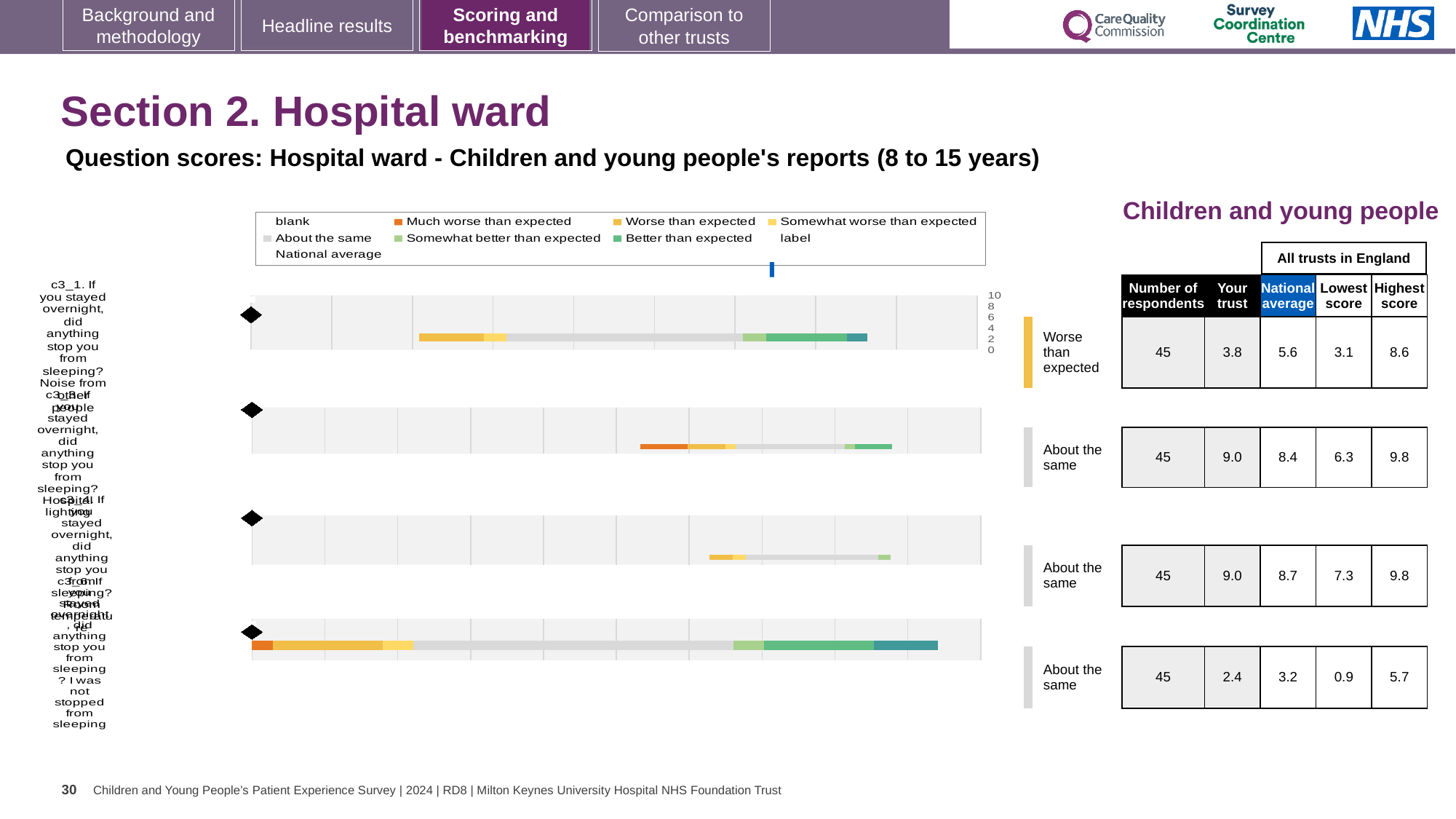
For the first question (c3_1), what is the difference between the highest score and the lowest score across all trusts in England? 5.5 What is the lowest 'Your trust' score shown in the table? 2.4 In the table beside the chart, what is the national average for the first question (c3_1)? 5.6 For the fourth question (bottom row), what is the difference between the national average and the 'Your trust' score? 0.8 Which legend entry is shown in orange? Much worse than expected In the table beside the chart, what is the 'Your trust' score for the first question (c3_1, noise from other people)? 3.8 What benchmark category is given for the first question (c3_1)? Worse than expected How many horizontal bars (questions) are plotted in the chart? 4 How many respondents are listed for each question in the table? 45 What type of chart is shown on the slide? bar chart For the first question (c3_1), which is larger: the 'Your trust' score or the national average? National average How many entries does the chart legend list? 9